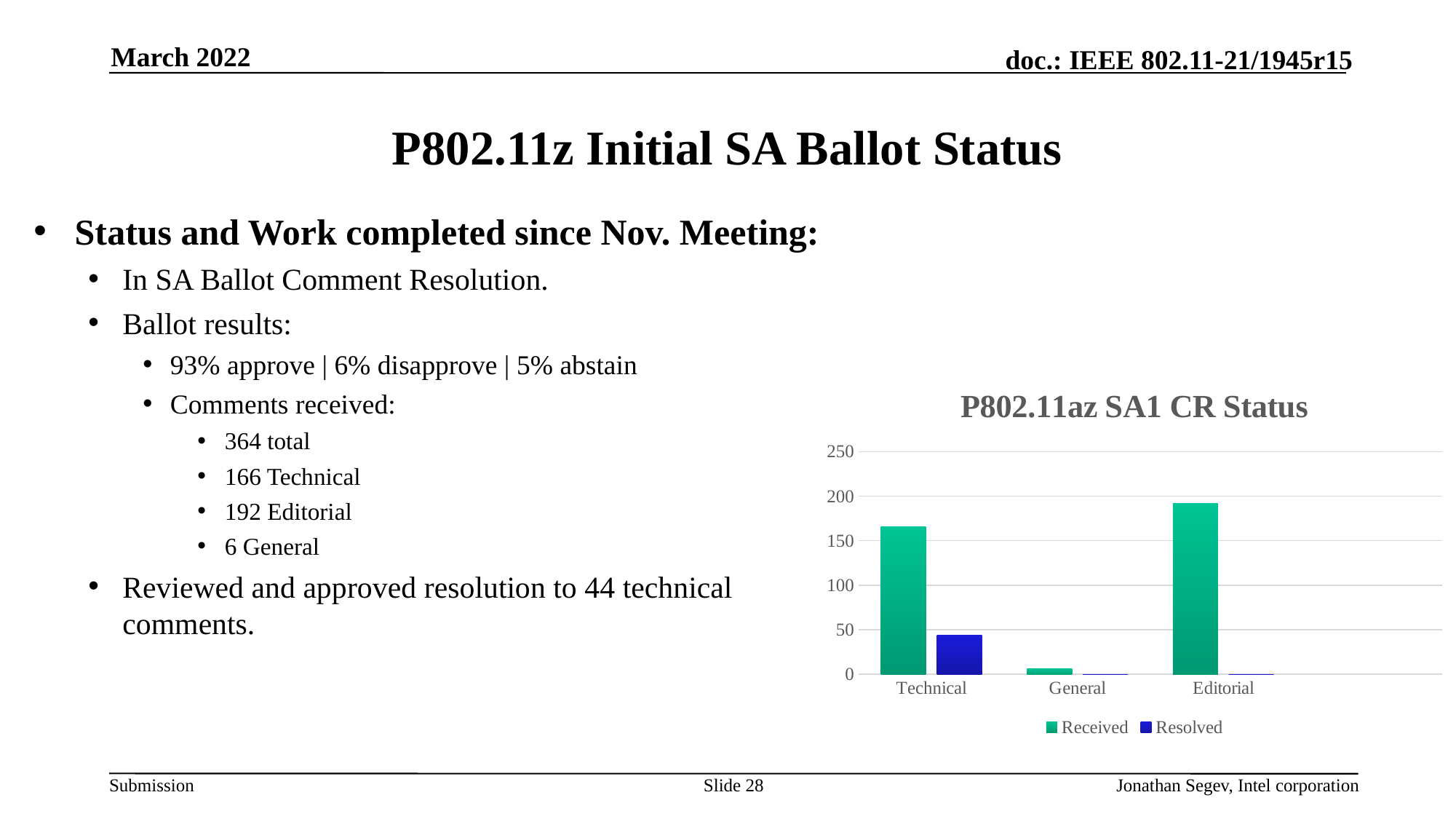
Which category has the highest Resolved value? Technical Which is larger: the Received value for Technical or the Received value for Editorial? Editorial What type of chart is shown on the slide? bar chart Is the Received value for Technical greater or less than 150? greater Which series is shown in blue in the chart? Resolved Which category has the highest Received value? Editorial Which category has the lowest Received value? General How many series does the chart legend list? 2 Is the Resolved value for Technical greater or less than 50? less What is the title of the chart? P802.11az SA1 CR Status Is the Received value for Editorial greater or less than 200? less How many categories are shown on the x axis of the chart? 3